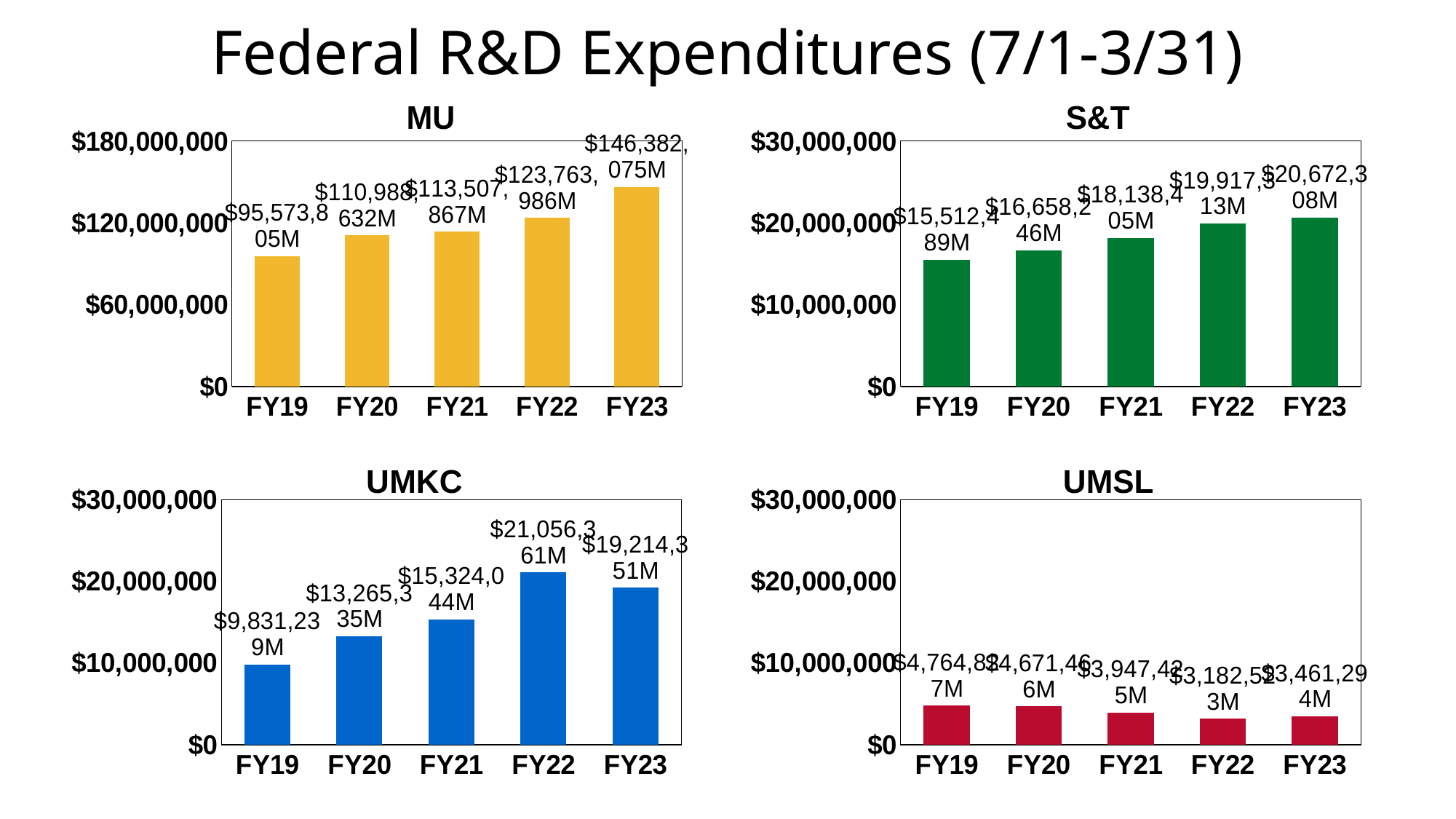
How many fiscal years are shown on the x axis of the UMKC chart? 5 What kind of chart is the MU chart? bar chart How many charts are shown on the slide? 4 In the MU chart, what is the difference between the FY23 and FY19 values? $50,808,270M In the UMSL chart, which fiscal year has the lowest value? FY22 In the UMKC chart, which fiscal year has the highest value? FY22 In the MU chart, what is the value for FY23? $146,382,075M Which is larger: the FY23 value in the UMKC chart or the FY23 value in the S&T chart? S&T FY23 In the UMSL chart, what is the value for FY21? $3,947,425M In the MU chart, is the value for FY19 greater or less than $120,000,000? less In the UMKC chart, what is the difference between the FY22 and FY23 values? $1,842,010M In the S&T chart, do the values rise or fall from FY19 to FY23? rise